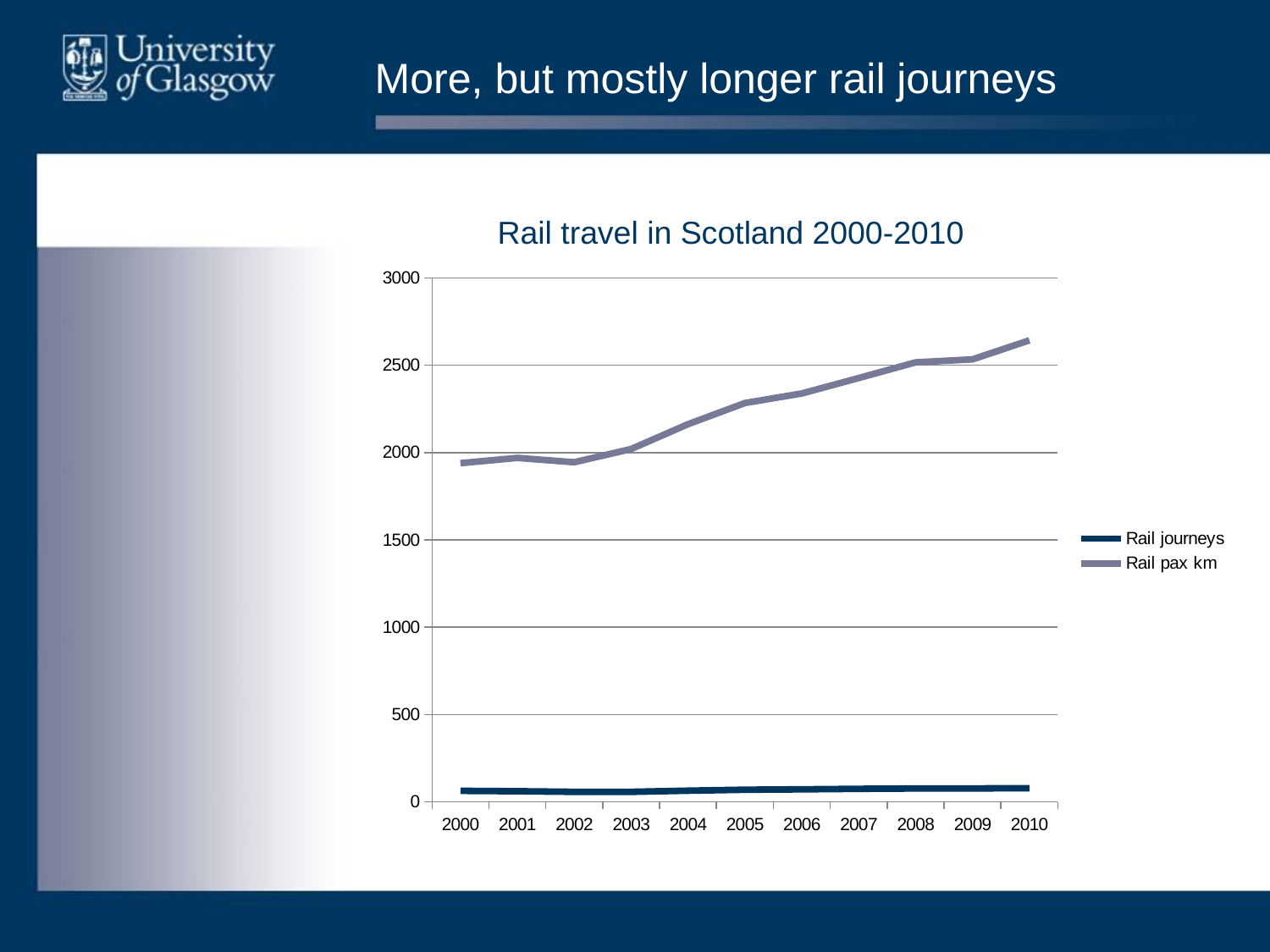
Is the Rail pax km value for 2010 greater or less than 2500? greater Is the Rail pax km value for 2006 greater or less than 2000? greater Does the Rail pax km series generally rise or fall from 2000 to 2010? Rise What kind of chart is shown on the slide? Line chart How many series does the legend list? 2 In which year is the Rail pax km value highest? 2010 How many years are shown on the x axis? 11 Which series has the larger value in 2010, Rail journeys or Rail pax km? Rail pax km What is the title of the chart? Rail travel in Scotland 2000-2010 Is the Rail pax km value for 2000 greater or less than 2000? less What are the two series named in the legend? Rail journeys and Rail pax km